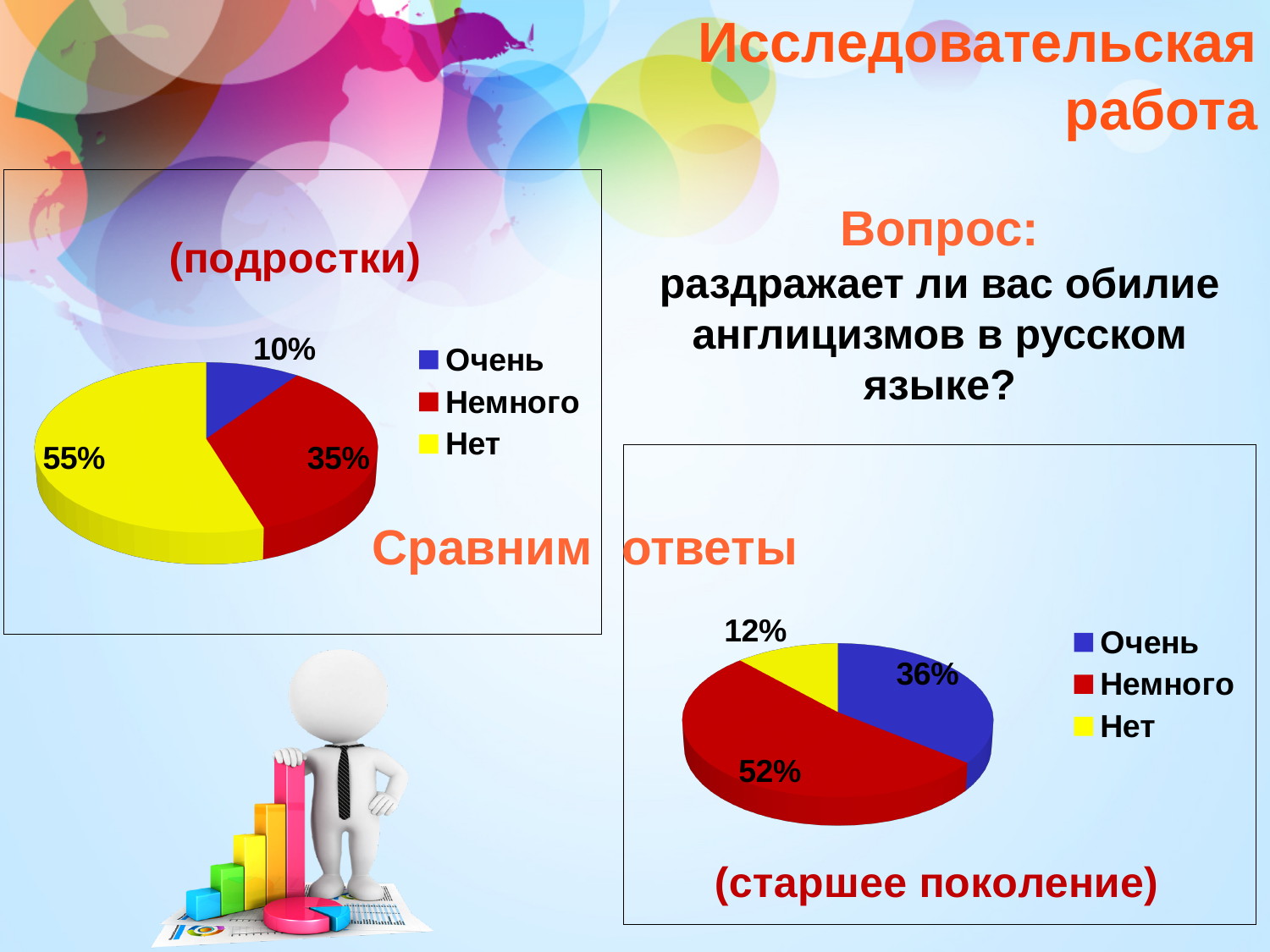
Which is larger: the "Очень" share in the "(подростки)" chart or the "Очень" share in the "(старшее поколение)" chart? (старшее поколение) In the "(подростки)" pie chart, what share of respondents answered "Очень"? 10% In the "(подростки)" pie chart, what is the difference between the "Нет" share and the "Немного" share? 20% How many slices does the "(старшее поколение)" pie chart have? 3 What type of chart is the "(подростки)" chart? Pie chart In the "(старшее поколение)" pie chart, what share of respondents answered "Немного"? 52% In the "(старшее поколение)" pie chart, what share of respondents answered "Нет"? 12% In the "(подростки)" pie chart, what share of respondents answered "Нет"? 55% In the "(старшее поколение)" pie chart, which answer has the largest share? Немного In the "(подростки)" pie chart, which answer has the largest share? Нет In the "(подростки)" chart legend, which colour represents "Немного"? Red In the "(старшее поколение)" pie chart, which answer has the smallest share? Нет